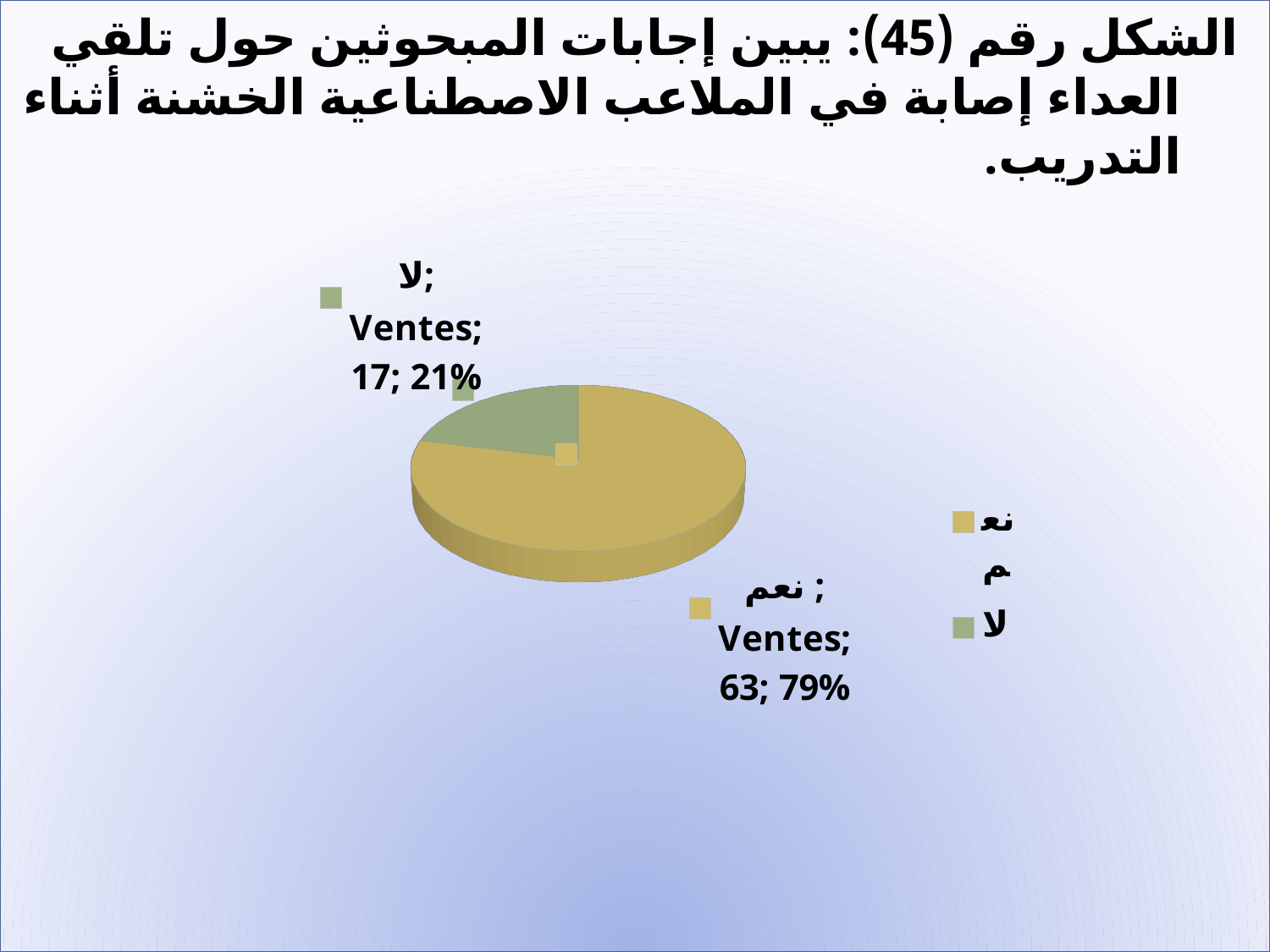
How many slices does the pie chart have? 2 What is the total of the two slice values? 80 What is the value for نعم? 63 What kind of chart is shown on the slide? pie chart What is the difference between the values for نعم and لا? 46 What is the value for لا? 17 Which is larger, the value for نعم or the value for لا? نعم What percentage share does the نعم slice have? 79% What series name appears in the data labels? Ventes Which category has the smallest slice? لا What percentage share does the لا slice have? 21% Which category has the largest slice? نعم